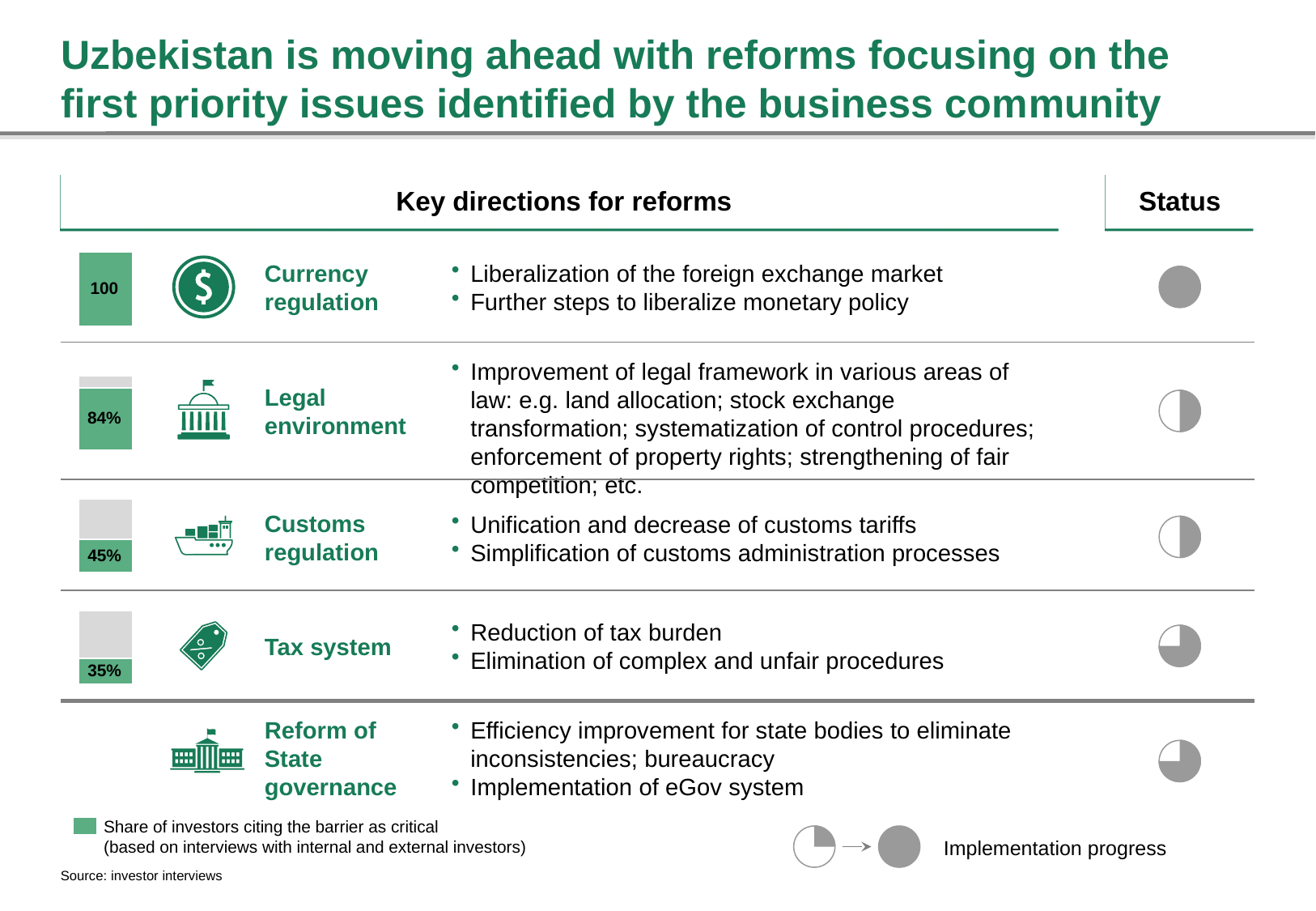
Among the reform directions with a bar shown, which has the lowest share of investors citing it as critical? Tax system Which has a larger share of investors citing it as critical: Legal environment or Tax system? Legal environment What is the difference in percentage points between the shares for Legal environment and Customs regulation? 39 percentage points What share of investors cited Legal environment as a critical barrier? 84% What value is shown on the bar for Currency regulation? 100 Which reform direction has the highest share of investors citing it as a critical barrier? Currency regulation What is the difference in percentage points between the shares for Customs regulation and Tax system? 10 percentage points According to the legend, what do the green bars represent? Share of investors citing the barrier as critical What share of investors cited Tax system as a critical barrier? 35% What kind of chart is used to show the share of investors citing each barrier as critical? Bar chart What share of investors cited Customs regulation as a critical barrier? 45% How many reform directions have a share-of-investors bar shown next to them? 4